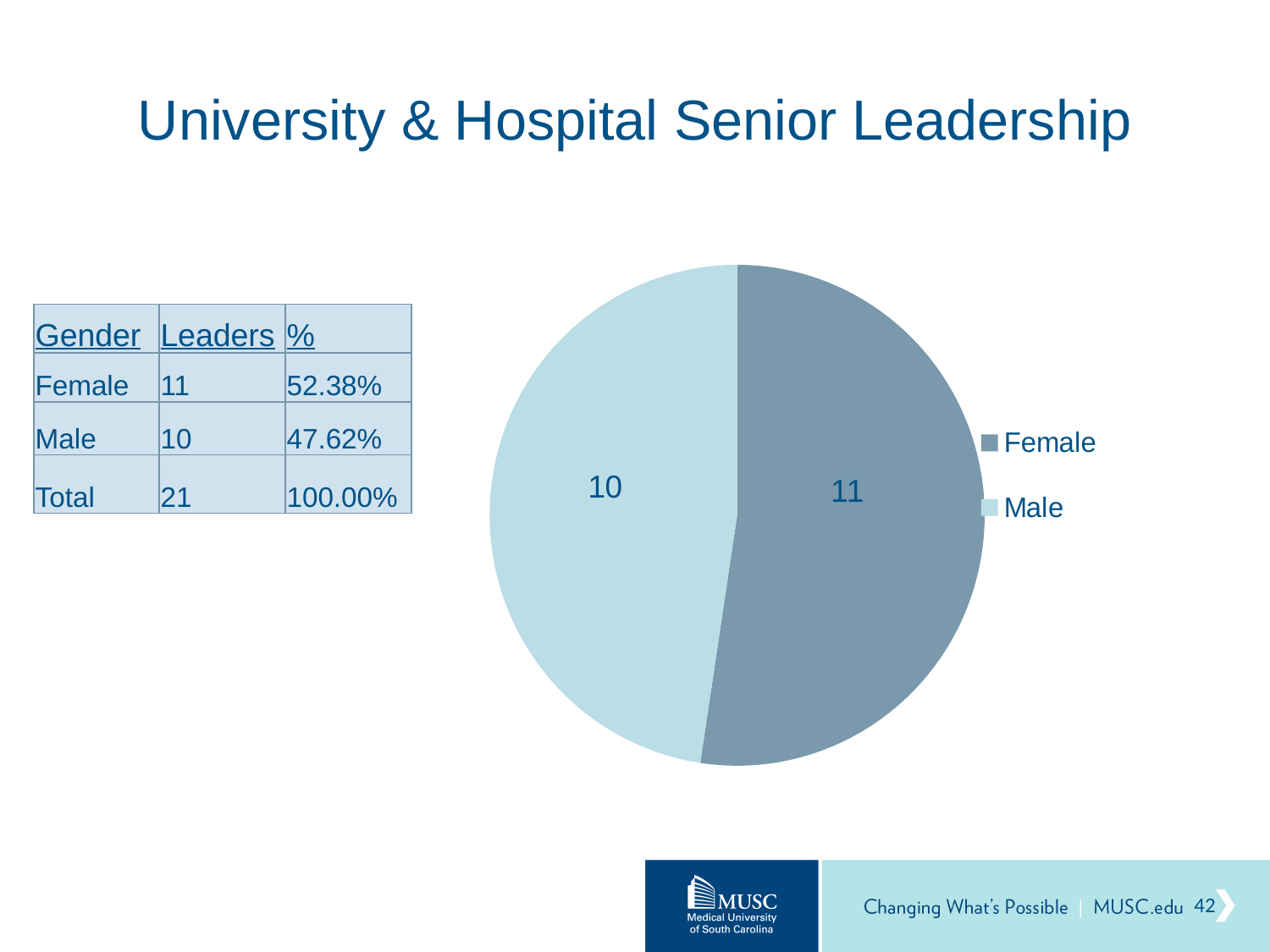
What kind of chart is shown on the slide? pie chart How many slices does the pie chart have? 2 Which gender has the smaller slice in the pie chart? Male What is the total of the two slices in the pie chart? 21 How many leaders are Male according to the pie chart? 10 How many leaders are Female according to the pie chart? 11 What is the difference between the Female and Male values in the pie chart? 1 Which gender has the larger slice in the pie chart? Female What is the title of the slide containing the pie chart? University & Hospital Senior Leadership Is the Female value larger or smaller than the Male value in the pie chart? larger How many entries does the pie chart's legend list? 2 What share of the pie does the Female slice represent, as shown in the table? 52.38%